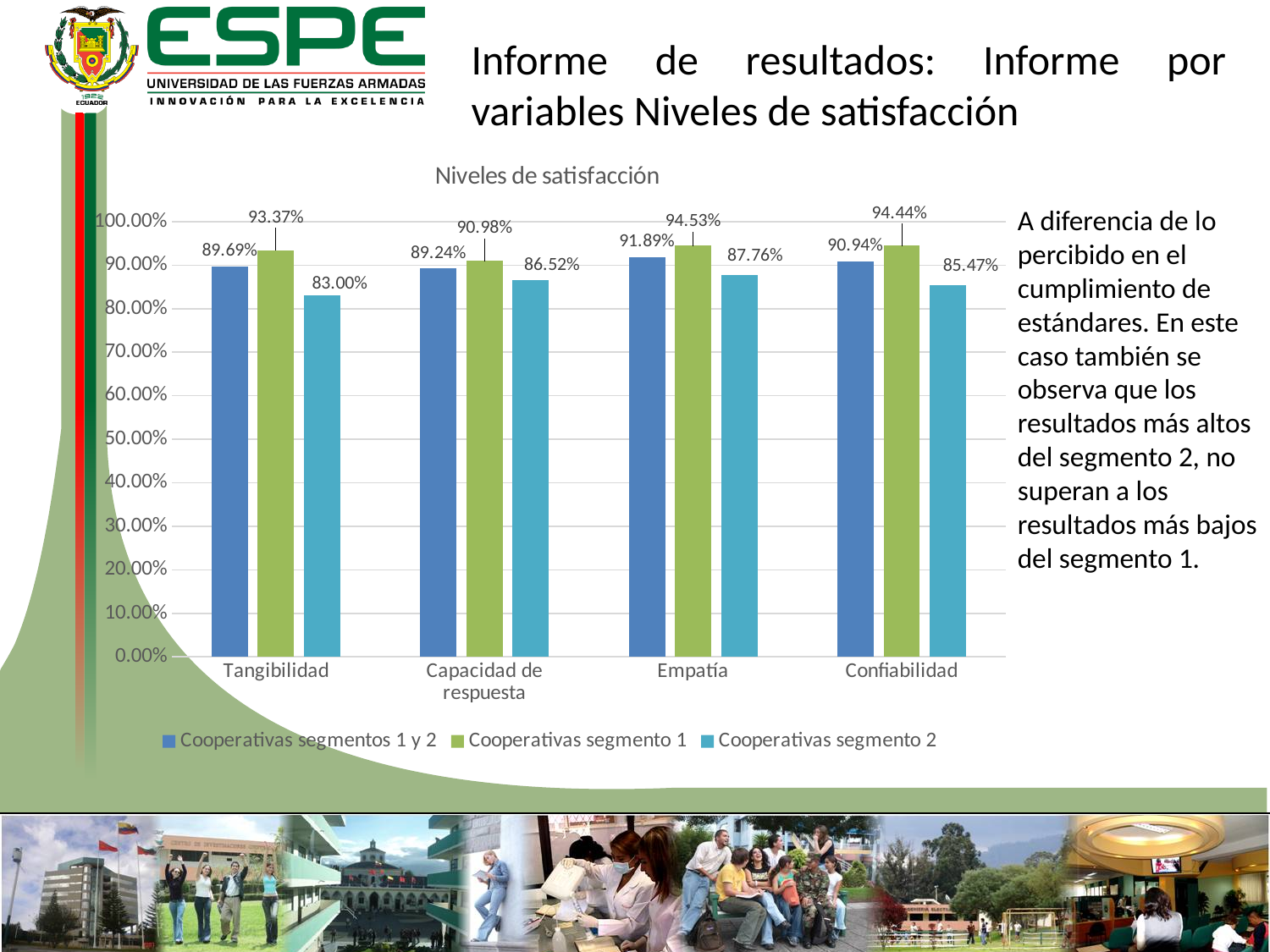
What type of chart is shown on the slide? Bar chart In which category does Cooperativas segmento 1 have its highest value? Empatía What is the title of the chart? Niveles de satisfacción How many series does the legend list? 3 What is the value for Cooperativas segmento 1 in the Tangibilidad category? 93.37% What is the difference between Cooperativas segmento 1 and Cooperativas segmento 2 in the Tangibilidad category? 10.37% In which category does Cooperativas segmento 2 have its lowest value? Tangibilidad What is the value for Cooperativas segmento 2 in the Confiabilidad category? 85.47% What is the value for Cooperativas segmentos 1 y 2 in the Empatía category? 91.89% How many categories are shown on the x axis? 4 What is the value for Cooperativas segmento 2 in the Capacidad de respuesta category? 86.52% Which is larger in the Confiabilidad category: Cooperativas segmentos 1 y 2 or Cooperativas segmento 2? Cooperativas segmentos 1 y 2